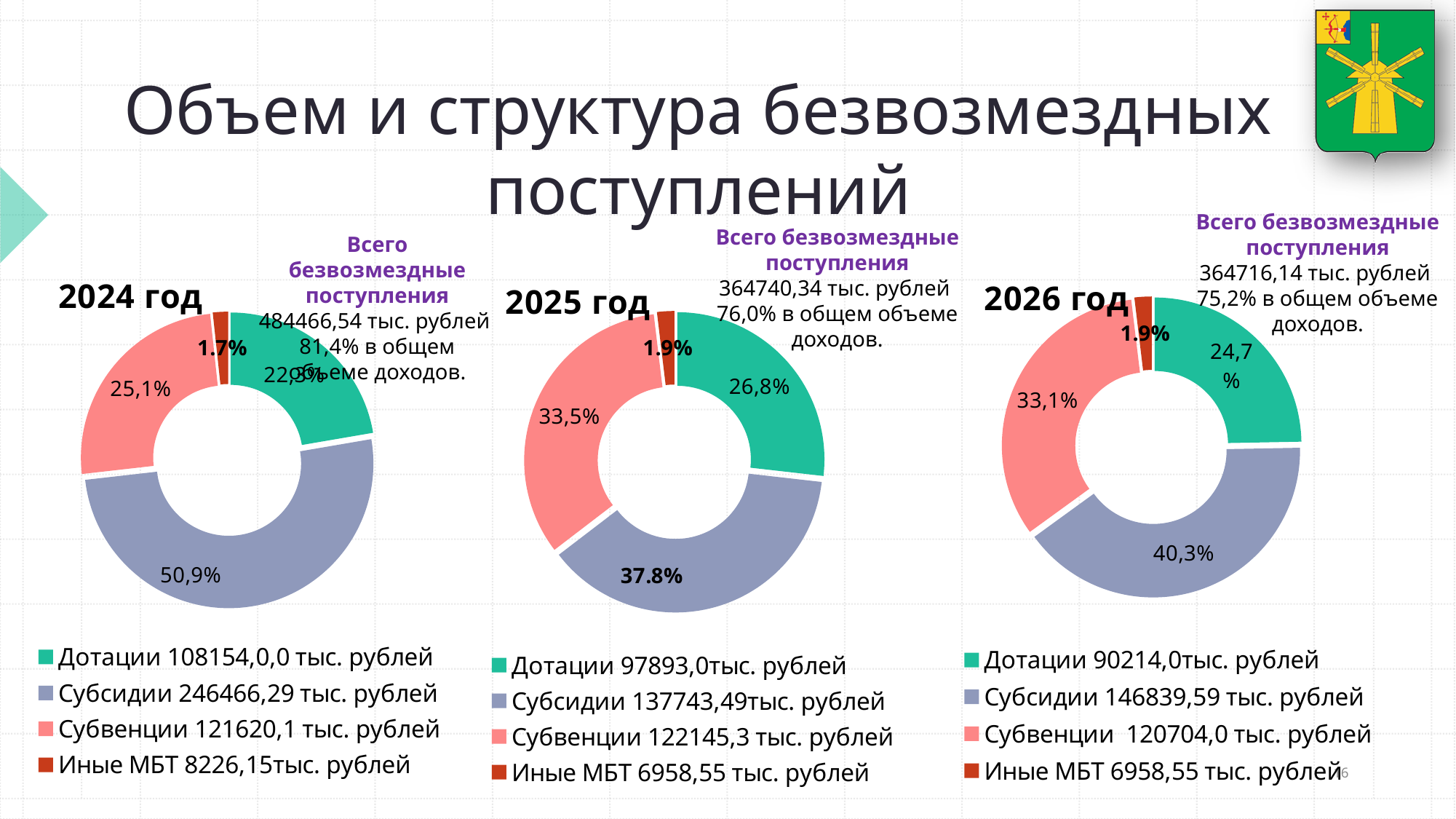
In the 2025 год chart, what is the difference between the shares of Субсидии and Субвенции? 4.3 percentage points In the 2025 год chart, what amount does the legend give for Иные МБТ? 6958,55 тыс. рублей In the 2026 год chart, what share does Субсидии have? 40,3% In the 2026 год chart, what amount does the legend give for Субсидии? 146839,59 тыс. рублей In the 2026 год chart, which is larger, the share of Дотации or the share of Субвенции? Субвенции In the 2024 год chart, what share does Субвенции have? 25,1% What kind of chart is used for the 2024 год chart? Pie (donut) chart In the 2025 год chart, what share does Дотации have? 26,8% In the 2024 год chart, what share does Субсидии have? 50,9% In the 2025 год chart, which category has the largest share? Субсидии How many categories does the legend of the 2026 год chart list? 4 In the 2024 год chart, which category has the smallest share? Иные МБТ